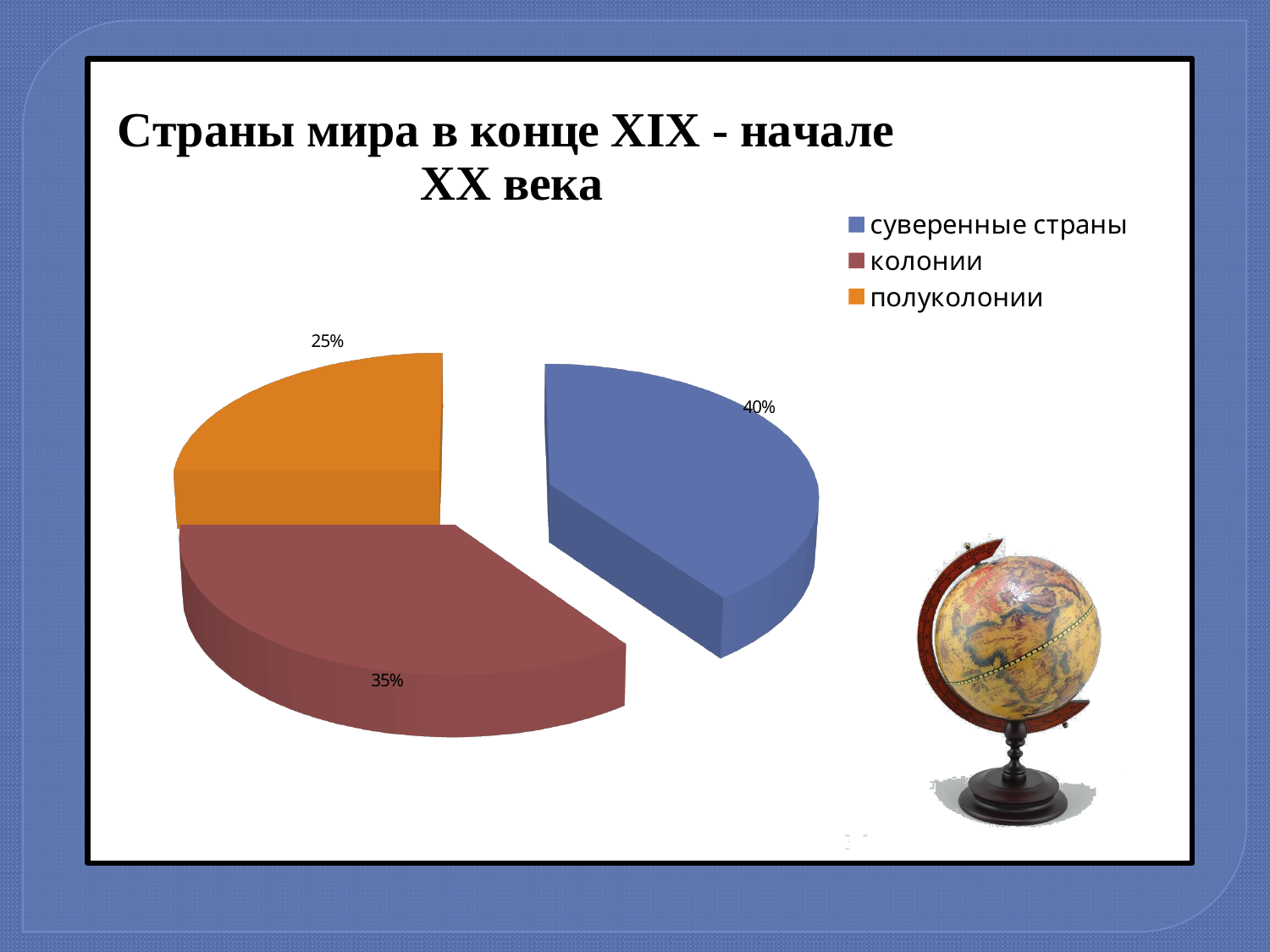
What is the title of the chart? Страны мира в конце XIX - начале XX века What share of the pie is labelled for полуколонии? 25% Which is larger, the slice for колонии or the slice for полуколонии? колонии What share of the pie is labelled for суверенные страны? 40% What is the difference in percentage points between колонии and полуколонии? 10 What is the difference in percentage points between суверенные страны and полуколонии? 15 How many slices does the pie chart have? 3 Which category has the smallest slice of the pie? полуколонии How many entries does the legend list? 3 Which category has the largest slice of the pie? суверенные страны What share of the pie is labelled for колонии? 35% What kind of chart is shown on the slide? pie chart